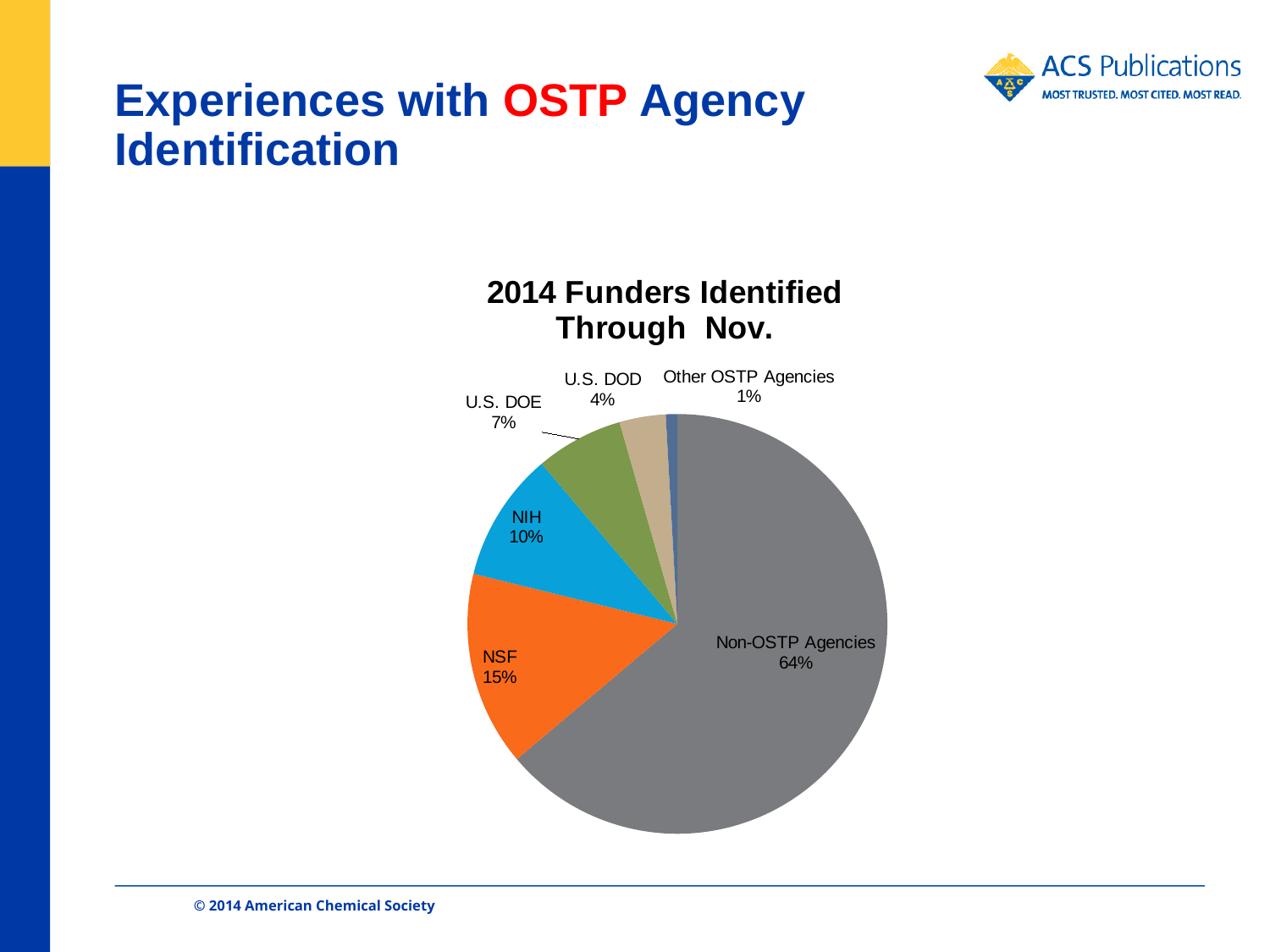
What percentage is shown for NIH? 10% How many slices does the pie chart have? 6 What kind of chart is shown on the slide? pie chart Which category has the smallest slice of the pie? Other OSTP Agencies Which is larger, the share for U.S. DOE or the share for U.S. DOD? U.S. DOE What share of the pie is Non-OSTP Agencies? 64% Which category has the largest slice of the pie? Non-OSTP Agencies What percentage is shown for U.S. DOD? 4% What percentage is shown for NSF? 15% What percentage is shown for U.S. DOE? 7% What is the title of the chart? 2014 Funders Identified Through Nov. What is the difference in percentage points between NSF and NIH? 5